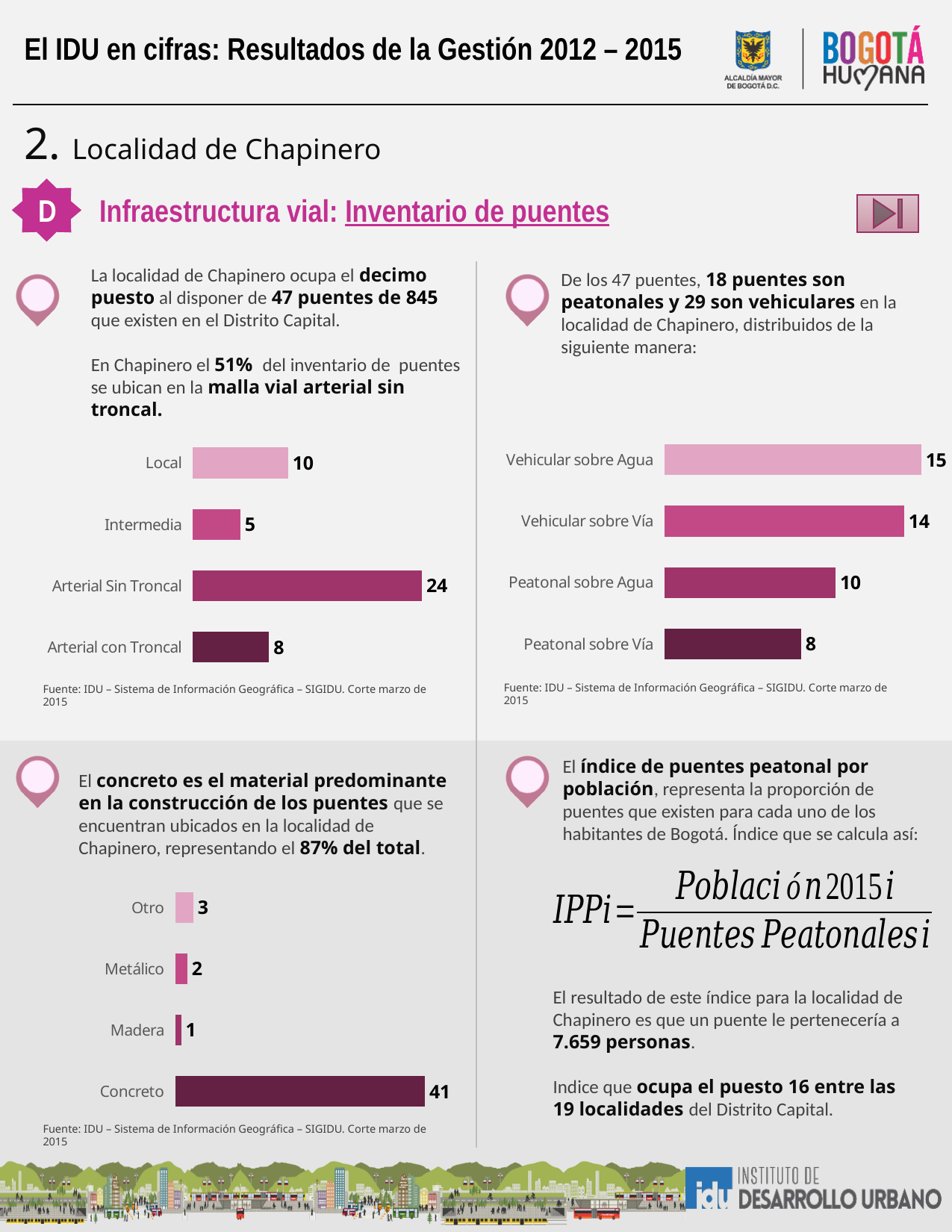
In the top-left bar chart, what is the difference between Arterial Sin Troncal and Local? 14 In the bottom-left bar chart, what is the difference between Concreto and Otro? 38 In the top-right bar chart, what is the difference between Vehicular sobre Vía and Peatonal sobre Vía? 6 In the top-left bar chart, which category has the lowest value? Intermedia In the top-right bar chart, which is larger: Vehicular sobre Agua or Peatonal sobre Agua? Vehicular sobre Agua What kind of chart is the bottom-left chart? Bar chart In the bottom-left bar chart, what is the value for Concreto? 41 In the top-right bar chart, what is the value for Peatonal sobre Agua? 10 In the top-right bar chart, which category has the highest value? Vehicular sobre Agua How many categories does the top-left bar chart show? 4 In the top-left bar chart, what is the value for Arterial Sin Troncal? 24 In the bottom-left bar chart, which category has the lowest value? Madera